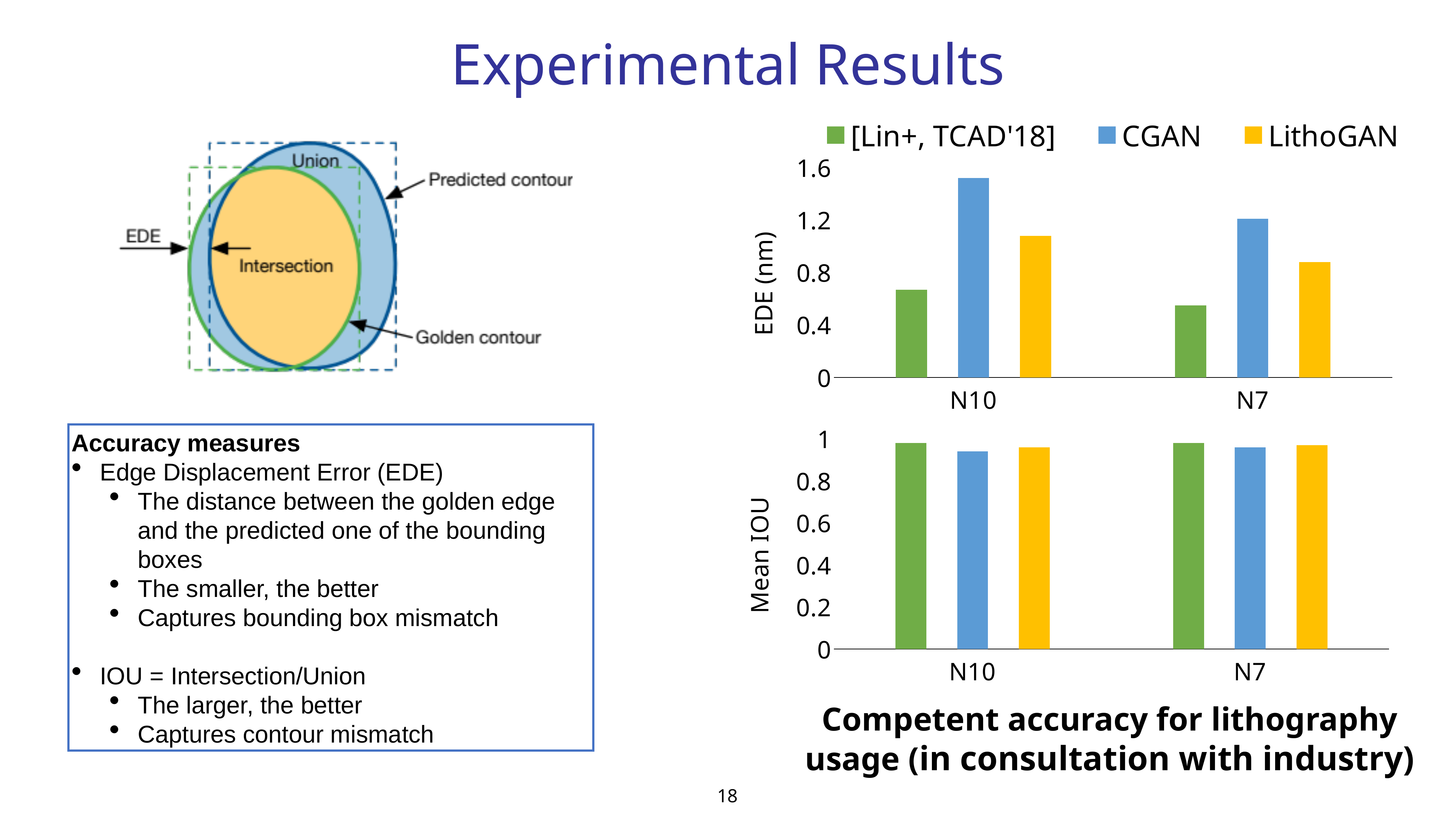
How many series does the legend list for the charts on the slide? 3 How many categories are shown on the x axis of the Mean IOU chart? 2 In the EDE (nm) chart, is the LithoGAN value at N7 greater or less than 1.2? less What kind of chart is the EDE (nm) chart on the slide? bar chart In the EDE (nm) chart, which series has the highest bar at N10? CGAN In the EDE (nm) chart, which is larger: the LithoGAN value at N10 or the LithoGAN value at N7? N10 What is the y-axis label of the lower chart on the slide? Mean IOU In the EDE (nm) chart, is the CGAN value at N10 greater or less than 1.2? greater In the EDE (nm) chart, which is larger at N7: CGAN or LithoGAN? CGAN In the Mean IOU chart, is the CGAN value at N10 greater or less than 0.8? greater In the EDE (nm) chart, which series has the lowest bar at N7? [Lin+, TCAD'18]